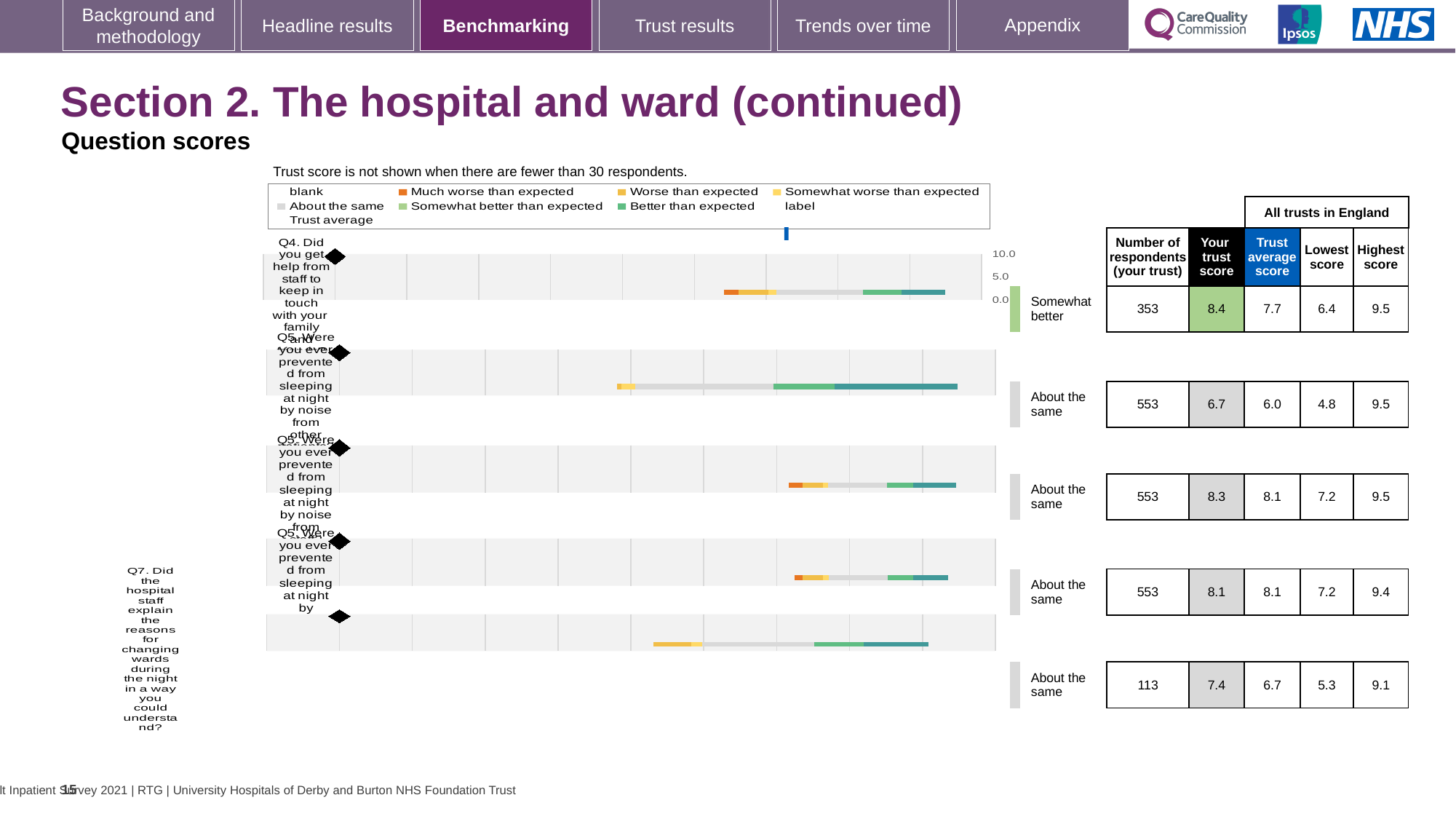
How many horizontal bars (question rows) are plotted in the chart? 5 In the table beside the chart, what is the difference between 'Your trust score' and the trust average score for the first row (Q4)? 0.7 In the table beside the chart, what is the trust average score for the last row (Q7)? 6.7 In the table beside the chart, what is 'Your trust score' for the first row (Q4)? 8.4 In the table beside the chart, what is the number of respondents for the first row (Q4)? 353 What colour does the legend use for 'Much worse than expected'? orange What benchmark category label is shown next to the first row (Q4)? Somewhat better What kind of chart is shown on the slide? bar chart In the table beside the chart, which row has the lowest number of respondents? the last row (Q7), 113 What note is printed directly above the chart legend? Trust score is not shown when there are fewer than 30 respondents. In the table beside the chart, what is the highest score for the last row (Q7)? 9.1 In the table beside the chart, which is larger for the last row (Q7): 'Your trust score' or the trust average score? Your trust score